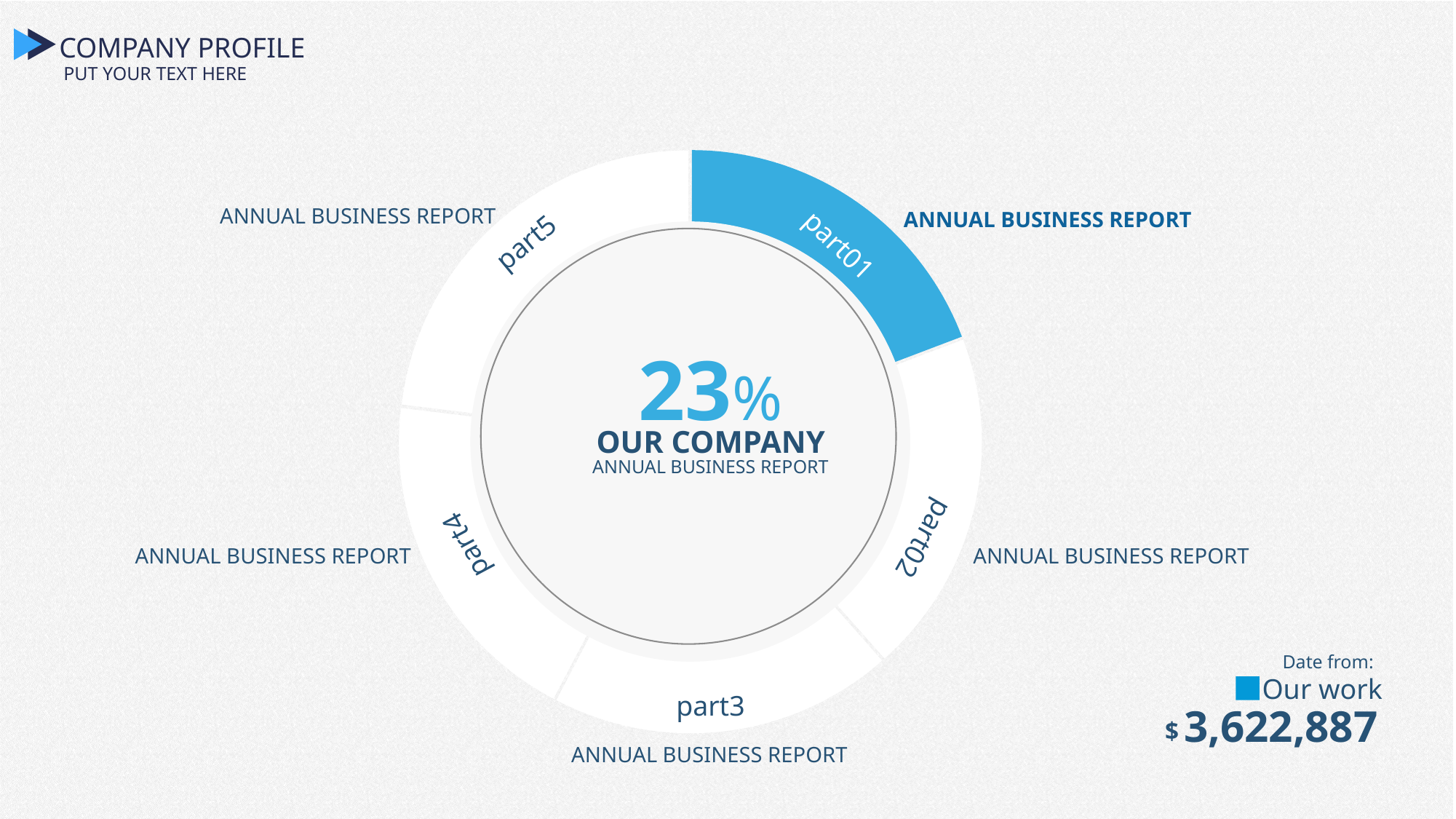
What kind of chart is shown on the slide? Donut (pie) chart What share of the donut chart does the highlighted segment part01 represent? 23% What dollar value is shown next to the 'Our work' legend entry? $3,622,887 What is the label of the segment to the upper left of the donut chart, between part4 and part01? part5 What text is printed directly below the 23% in the centre of the donut chart? OUR COMPANY What legend entry is shown with the blue square in the bottom right of the slide? Our work How many segments does the donut chart have? 5 Which segment of the donut chart is highlighted in blue? part01 What is the label of the segment at the bottom of the donut chart? part3 What percentage is printed in the centre of the donut chart? 23%